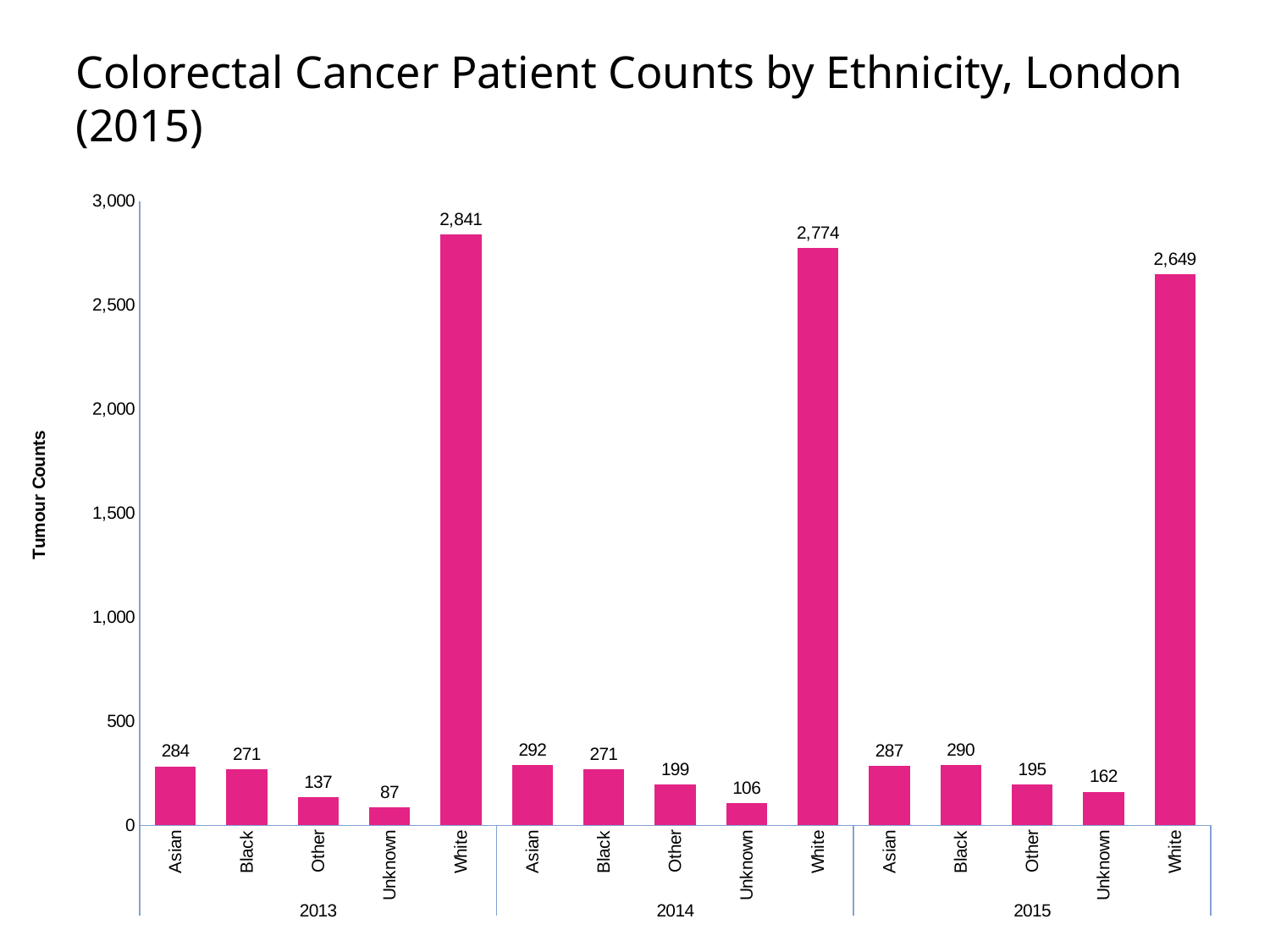
What is the tumour count for Other ethnicity in 2015? 195 What is the label on the vertical axis of the chart? Tumour Counts What is the difference between the White tumour counts in 2013 and 2015? 192 Which ethnicity has the lowest tumour count in 2013? Unknown Is the tumour count for White patients in 2014 greater or less than 2,500? greater Which is larger, the Unknown count in 2015 or the Unknown count in 2013? Unknown count in 2015 How many bars are plotted in the chart? 15 Which ethnicity has the highest tumour count in 2015? White What is the tumour count for White patients in 2013? 2,841 What is the difference between the Asian and Black tumour counts in 2014? 21 What is the tumour count for Unknown ethnicity in 2014? 106 What kind of chart is shown on the slide? Bar chart